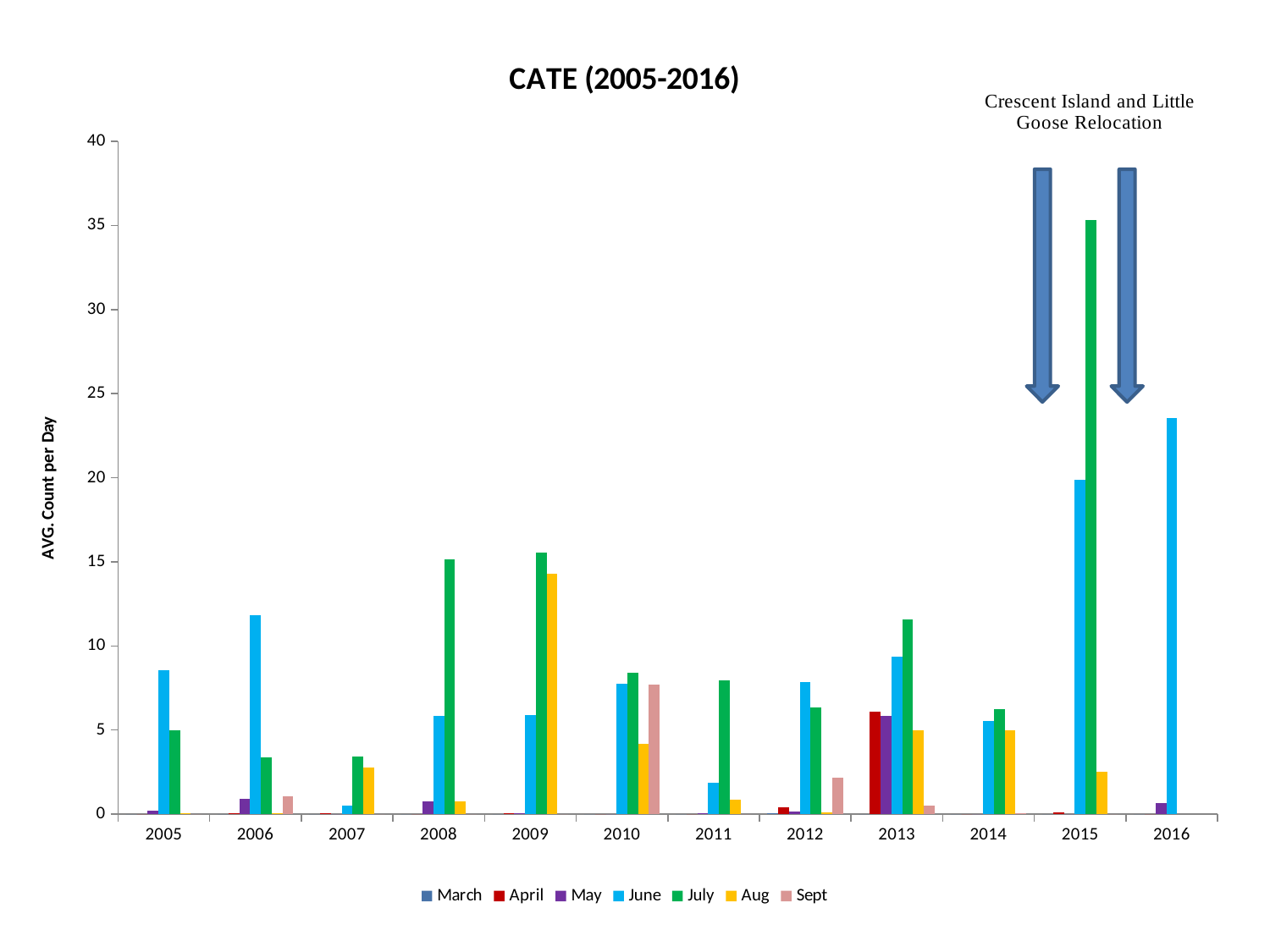
In which year is the July bar the highest? 2015 Is the value for June in 2006 greater or less than 10? greater How many series does the legend list? 7 In which year is the June bar the highest? 2016 In 2008, which is larger, the June bar or the July bar? July What is the label on the y axis of the chart? AVG. Count per Day How many years are shown along the x axis? 12 What kind of chart is shown on the slide? bar chart In 2012, which is larger, the June bar or the July bar? June Is the value for Sept in 2010 greater or less than 5? greater Is the value for June in 2016 greater or less than 20? greater